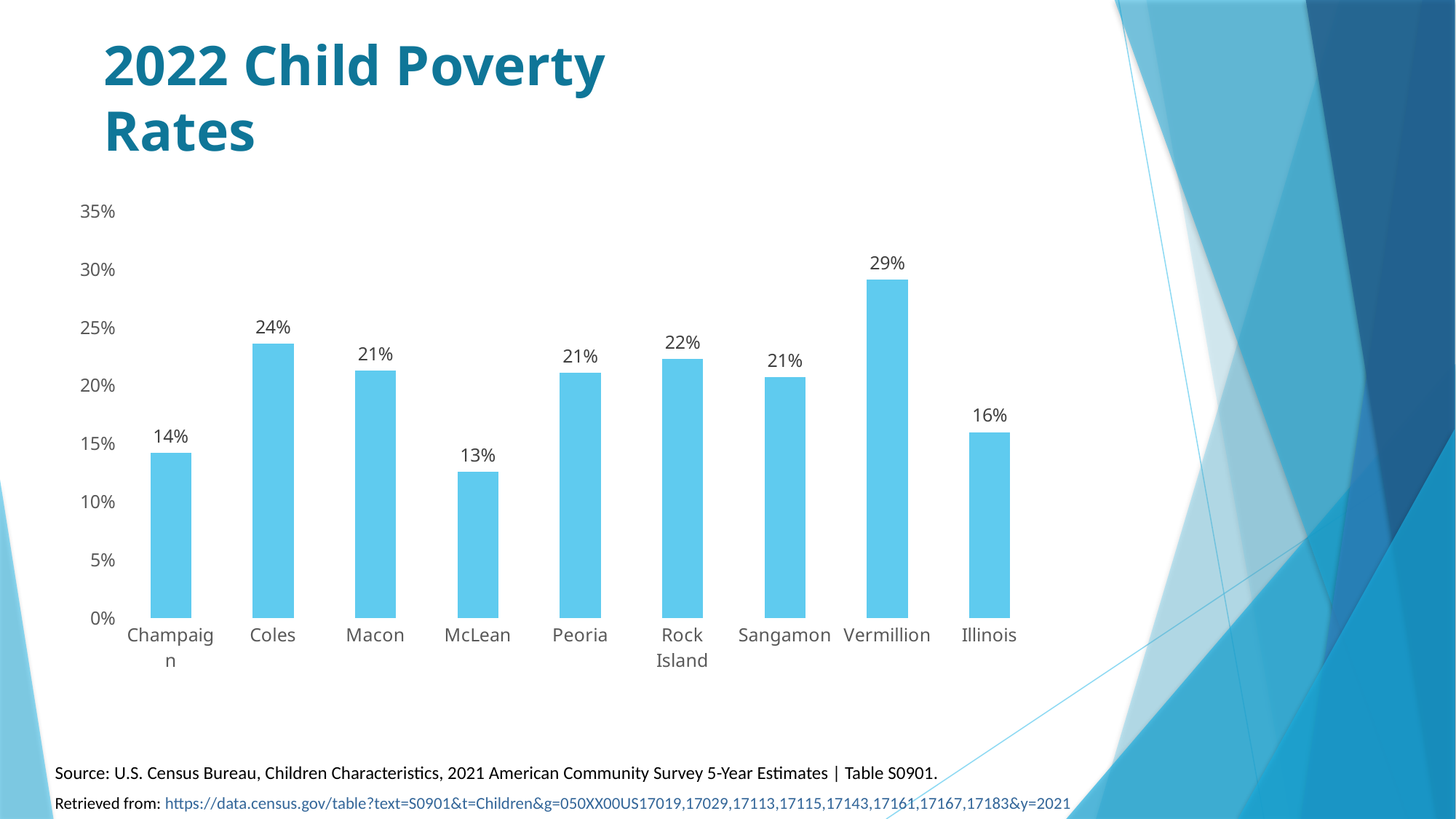
What is the child poverty rate for Illinois? 16% What is the child poverty rate for Rock Island? 22% Which county has the lowest child poverty rate? McLean How many categories are shown on the x axis? 9 What is the child poverty rate for McLean? 13% What is the title of the slide? 2022 Child Poverty Rates What is the difference between the child poverty rates of Vermillion and McLean? 16% What kind of chart is shown on the slide? Bar chart Which county has the highest child poverty rate? Vermillion What is the difference between the child poverty rates of Coles and Illinois? 8% What is the child poverty rate for Vermillion? 29% Which has a higher child poverty rate, Coles or Champaign? Coles